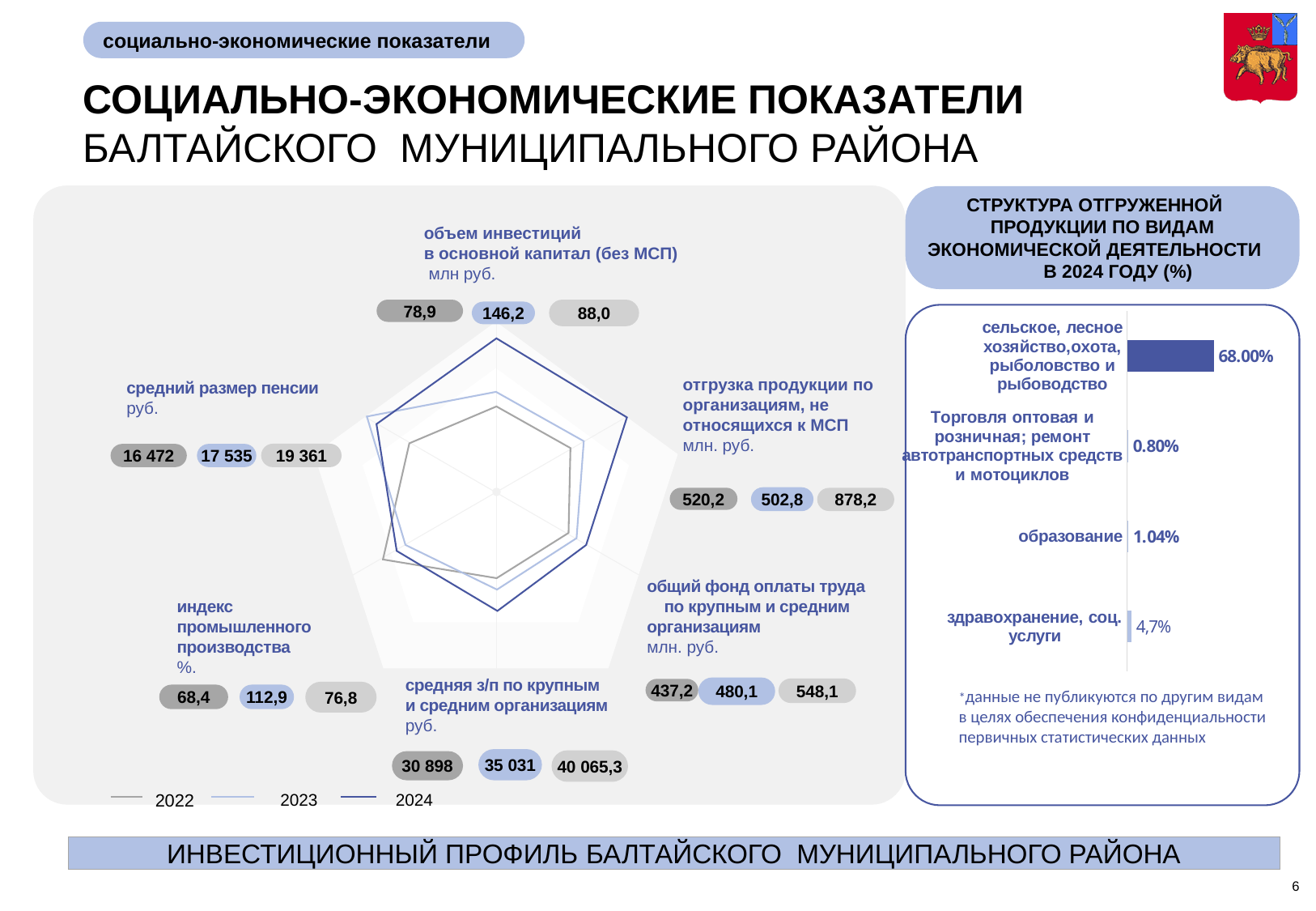
In the bar chart on the right, which category has the lowest value? Торговля оптовая и розничная; ремонт автотранспортных средств и мотоциклов In the radar chart, what is the 2024 value for 'средняя з/п по крупным и средним организациям'? 40 065,3 What kind of chart is the chart on the left of the slide? Radar chart In the bar chart on the right, what is the value for 'образование'? 1.04% In the bar chart on the right, which category has the highest value? сельское, лесное хозяйство, охота, рыболовство и рыбоводство In the radar chart, which is larger for 'индекс промышленного производства': the 2023 value or the 2024 value? 2023 (112,9) How many series does the legend of the radar chart list? 3 In the bar chart on the right, what share does 'сельское, лесное хозяйство, охота, рыболовство и рыбоводство' have? 68.00% In the radar chart, what is the difference between the 2024 and 2022 values for 'отгрузка продукции по организациям, не относящихся к МСП'? 358,0 In the radar chart, what is the 2023 value for 'объем инвестиций в основной капитал (без МСП)'? 146,2 How many categories are shown in the bar chart on the right? 4 In the radar chart, what is the 2024 value for 'средний размер пенсии'? 19 361